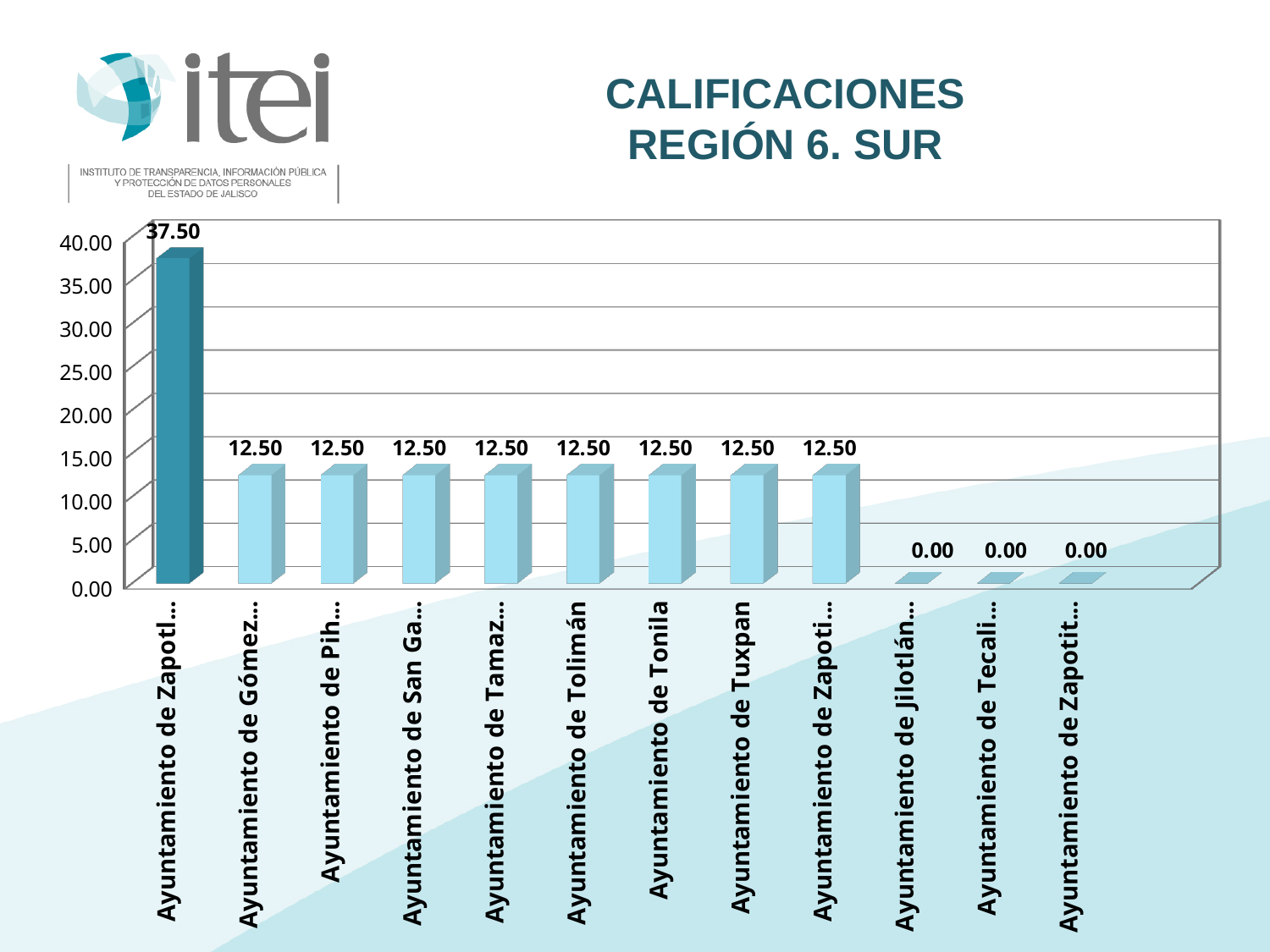
How many categories (bars) are shown on the chart? 12 What is the value for Ayuntamiento de Tolimán? 12.50 Is the value for Ayuntamiento de Tonila greater or less than 10.00? greater How many bars have a value of 12.50? 8 What is the title of the chart on the slide? CALIFICACIONES REGIÓN 6. SUR What kind of chart is shown on the slide? Bar chart What is the lowest value shown on the chart? 0.00 What is the highest value shown on the chart? 37.50 How many bars have a value of 0.00? 3 What is the value for Ayuntamiento de Tuxpan? 12.50 What is the value for Ayuntamiento de Tonila? 12.50 What is the difference between the highest value (37.50) and the value for Ayuntamiento de Tuxpan? 25.00